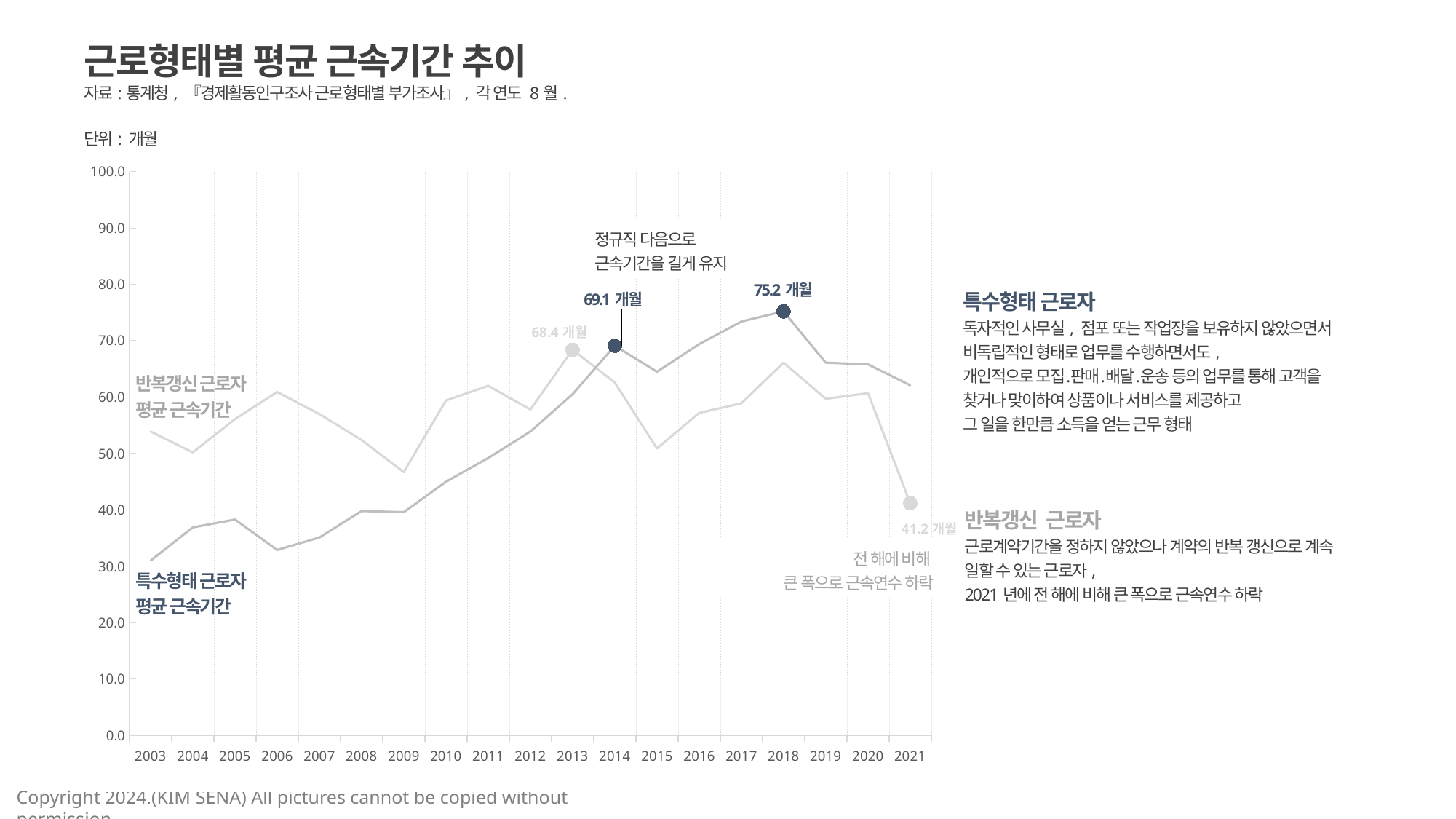
In which year does the 특수형태 근로자 line reach its highest value? 2018 What is the average tenure of 특수형태 근로자 in 2014? 69.1 개월 What is the average tenure of 반복갱신 근로자 in 2021? 41.2 개월 What is the average tenure of 특수형태 근로자 in 2018? 75.2 개월 What unit is used for the values in the chart? 개월 What is the average tenure of 반복갱신 근로자 in 2013? 68.4 개월 In which year is the 반복갱신 근로자 line at its lowest? 2021 By how much did the average tenure of 특수형태 근로자 increase from 2014 to 2018? 6.1 개월 How many years are shown on the x axis? 19 What is the difference between the 반복갱신 근로자 values in 2013 and 2021? 27.2 개월 Is the value for 특수형태 근로자 in 2003 greater or less than 40.0? less What type of chart is shown on the slide? line chart